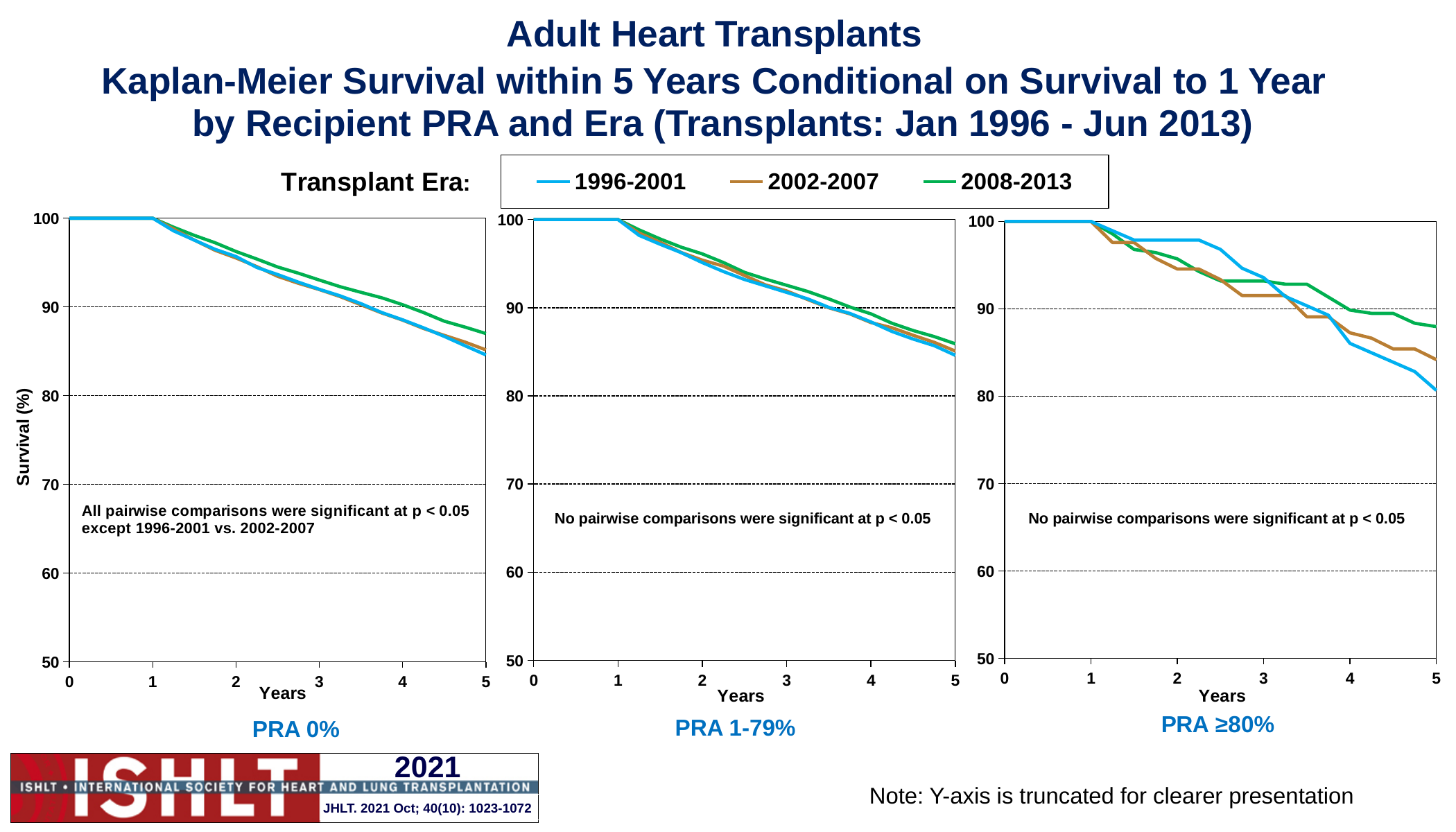
In the PRA ≥80% chart, which era has the lowest survival at year 5? 1996-2001 In the PRA ≥80% chart, which era has the highest survival at year 5? 2008-2013 In the PRA 0% chart, is the survival value for 1996-2001 at year 5 greater or less than 80? greater In the PRA 0% chart, is the survival value for 2008-2013 at year 5 greater or less than 90? less In the PRA ≥80% chart, does survival for the 1996-2001 era rise or fall from year 1 to year 5? fall How many labelled tick marks are on the Years axis of the PRA 1-79% chart? 6 What kind of chart is the PRA 0% chart? line chart Which era is drawn in green in the legend? 2008-2013 What is the lowest value shown on the Survival (%) axis of the PRA 1-79% chart? 50 In the PRA 0% chart, which is higher at year 5: survival for 2008-2013 or for 1996-2001? 2008-2013 In the PRA ≥80% chart, is the survival value for 2008-2013 at year 5 greater or less than 90? less How many series does the Transplant Era legend list? 3